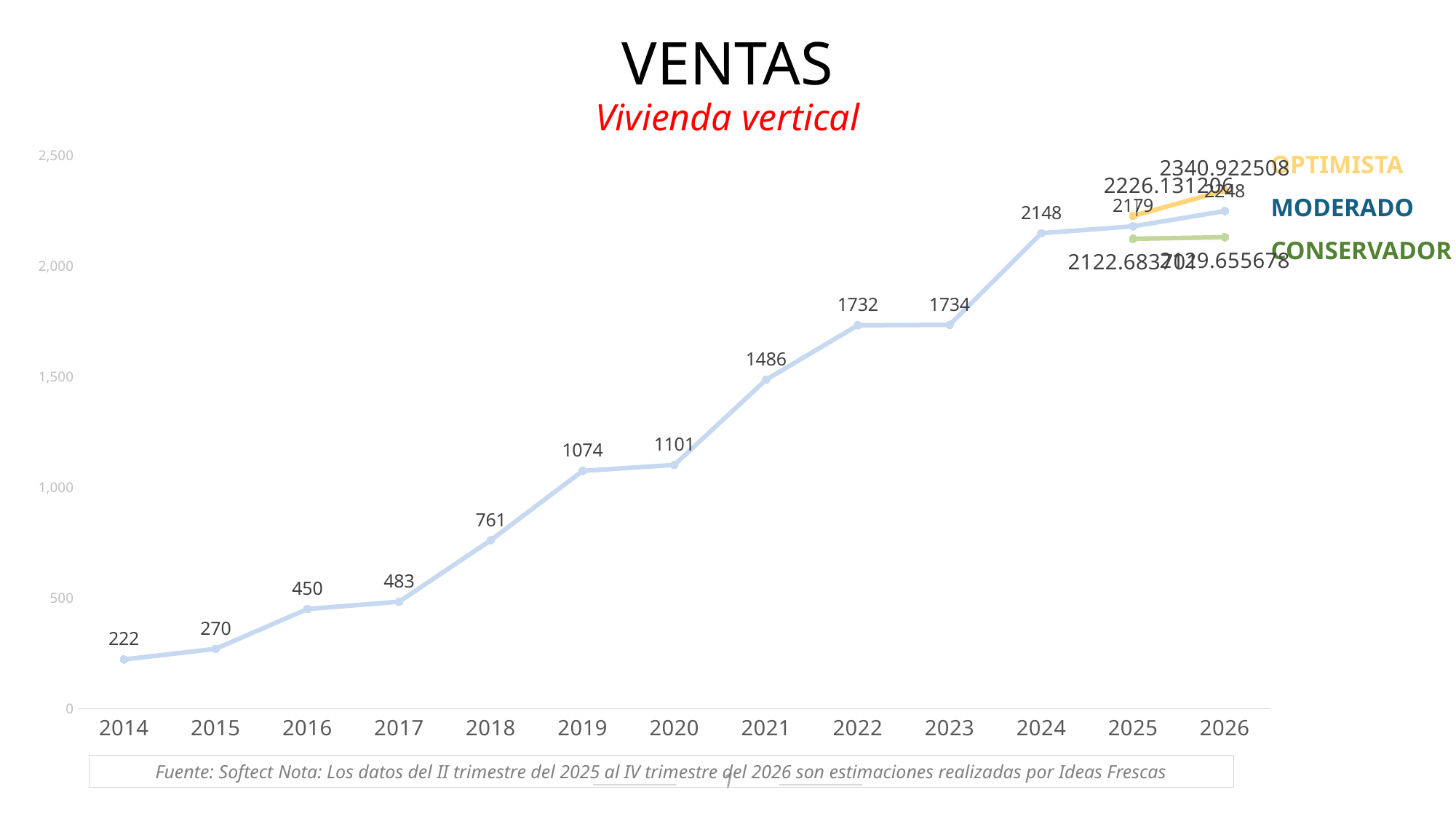
Which is larger, the value for 2020 or the value for 2019? 2020 What is the value for 2024? 2148 What is the value for 2022? 1732 Do the values generally rise or fall from 2014 to 2024? rise Which year has the lowest value on the main line? 2014 What is the difference between the values for 2018 and 2017? 278 What is the OPTIMISTA value for 2026? 2340.922508 What is the CONSERVADOR value for 2026? 2129.655678 What is the value for 2014? 222 What kind of chart is shown on the slide? line chart How many years are shown on the x axis? 13 What is the value for 2019? 1074